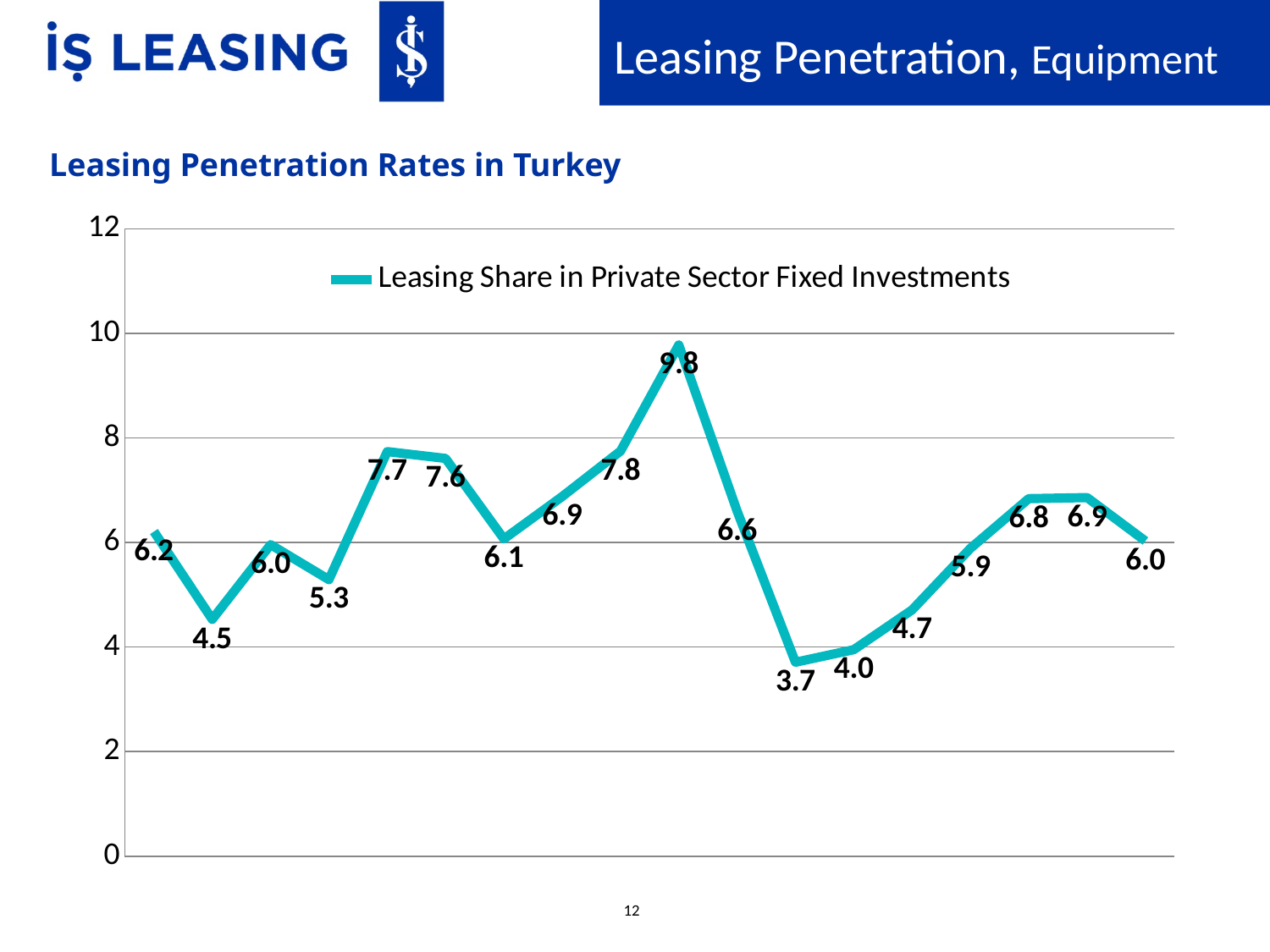
Which is larger, the first data point or the last data point on the line? the first data point (6.2) What kind of chart is shown on the slide? line chart Is the peak value of the line greater or less than 8? greater What is the value of the last data point on the line? 6.0 How many series does the legend list? 1 What is the lowest value plotted on the line? 3.7 How many data points are plotted on the line? 18 What is the difference between the highest and lowest values on the line? 6.1 What is the value of the first data point on the line? 6.2 What is the highest value plotted on the line? 9.8 What is the name of the series shown in the legend? Leasing Share in Private Sector Fixed Investments What is the title printed above the chart? Leasing Penetration Rates in Turkey